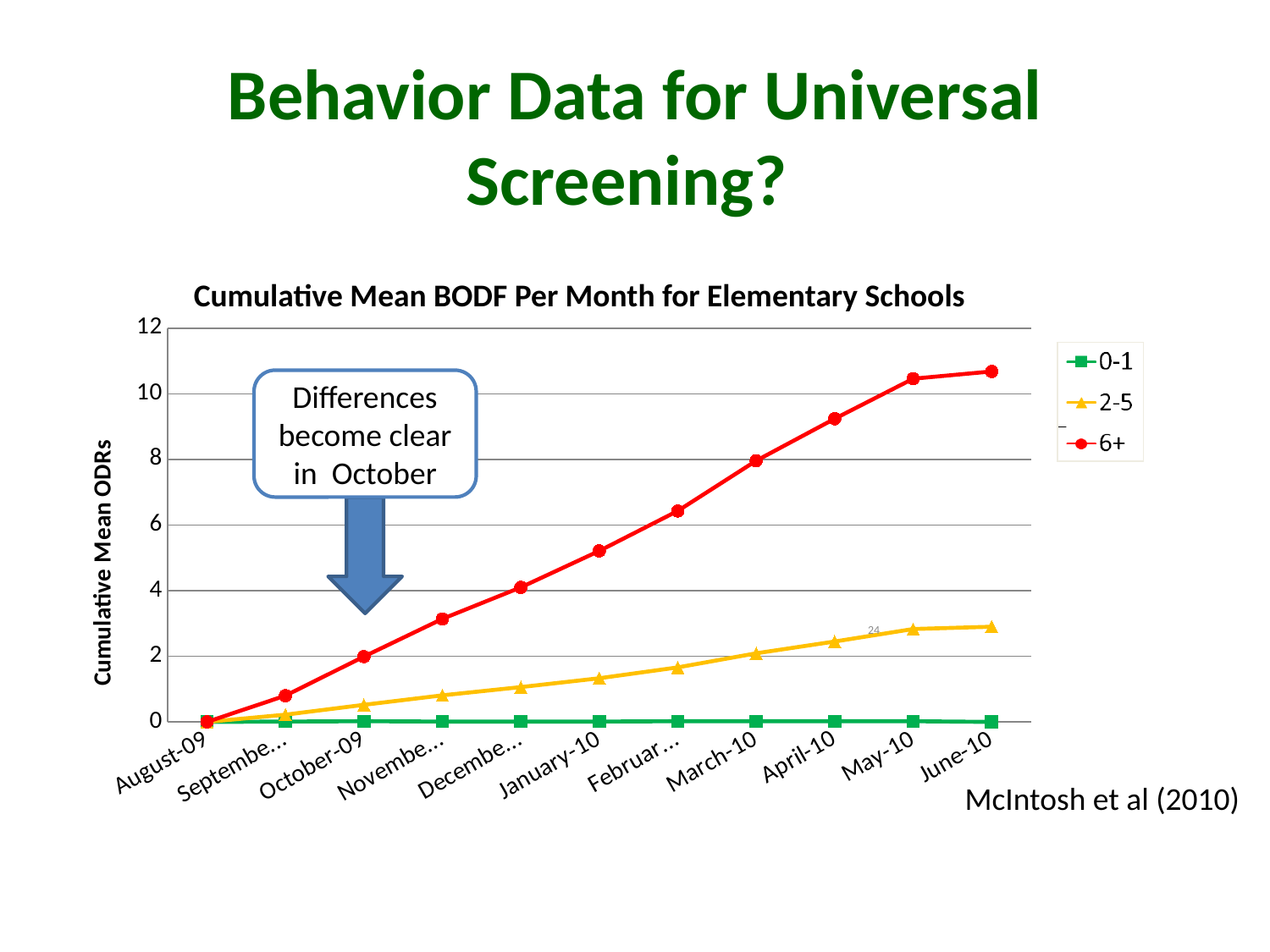
How many months are plotted along the x axis? 11 Which series has the highest value in June-10? 6+ What is the title of the chart? Cumulative Mean BODF Per Month for Elementary Schools Which series has the lowest value in June-10? 0-1 Which is larger in March-10, the value for the 6+ series or the 2-5 series? 6+ What kind of chart is shown on the slide? line chart What is the label on the y axis? Cumulative Mean ODRs How many series does the legend list? 3 Does the 6+ series rise or fall from August-09 to June-10? rise Is the value for the 6+ series in June-10 greater or less than 10? greater Is the value for the 6+ series in January-10 greater or less than 4? greater Is the value for the 2-5 series in June-10 greater or less than 4? less